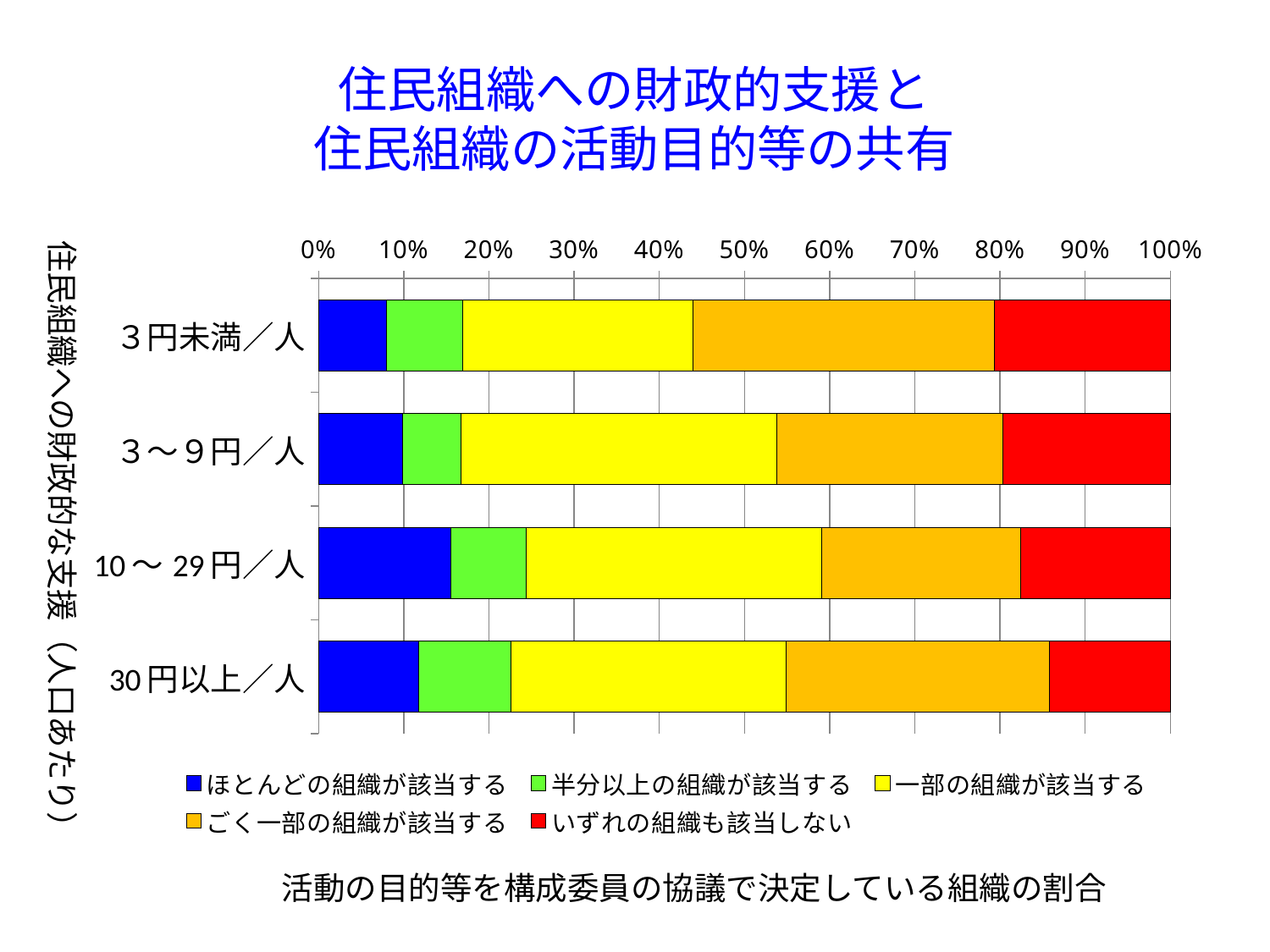
What kind of chart is shown on the slide? Stacked bar chart How many series does the legend list? 5 Which category has the largest blue (ほとんどの組織が該当する) segment? 10～29円／人 Is the blue (ほとんどの組織が該当する) segment for 10～29円／人 greater or less than 10%? greater Which legend entry is shown in blue? ほとんどの組織が該当する Which category has the smallest yellow (一部の組織が該当する) segment? ３円未満／人 Is the blue (ほとんどの組織が該当する) segment larger for 10～29円／人 or for ３円未満／人? 10～29円／人 Which category has the largest orange (ごく一部の組織が該当する) segment? ３円未満／人 Is the orange (ごく一部の組織が該当する) segment for ３円未満／人 greater or less than 30%? greater Which category has the smallest red (いずれの組織も該当しない) segment? 30円以上／人 How many categories (financial support levels) are plotted on the chart? 4 What is the title of the chart on the slide? 住民組織への財政的支援と住民組織の活動目的等の共有